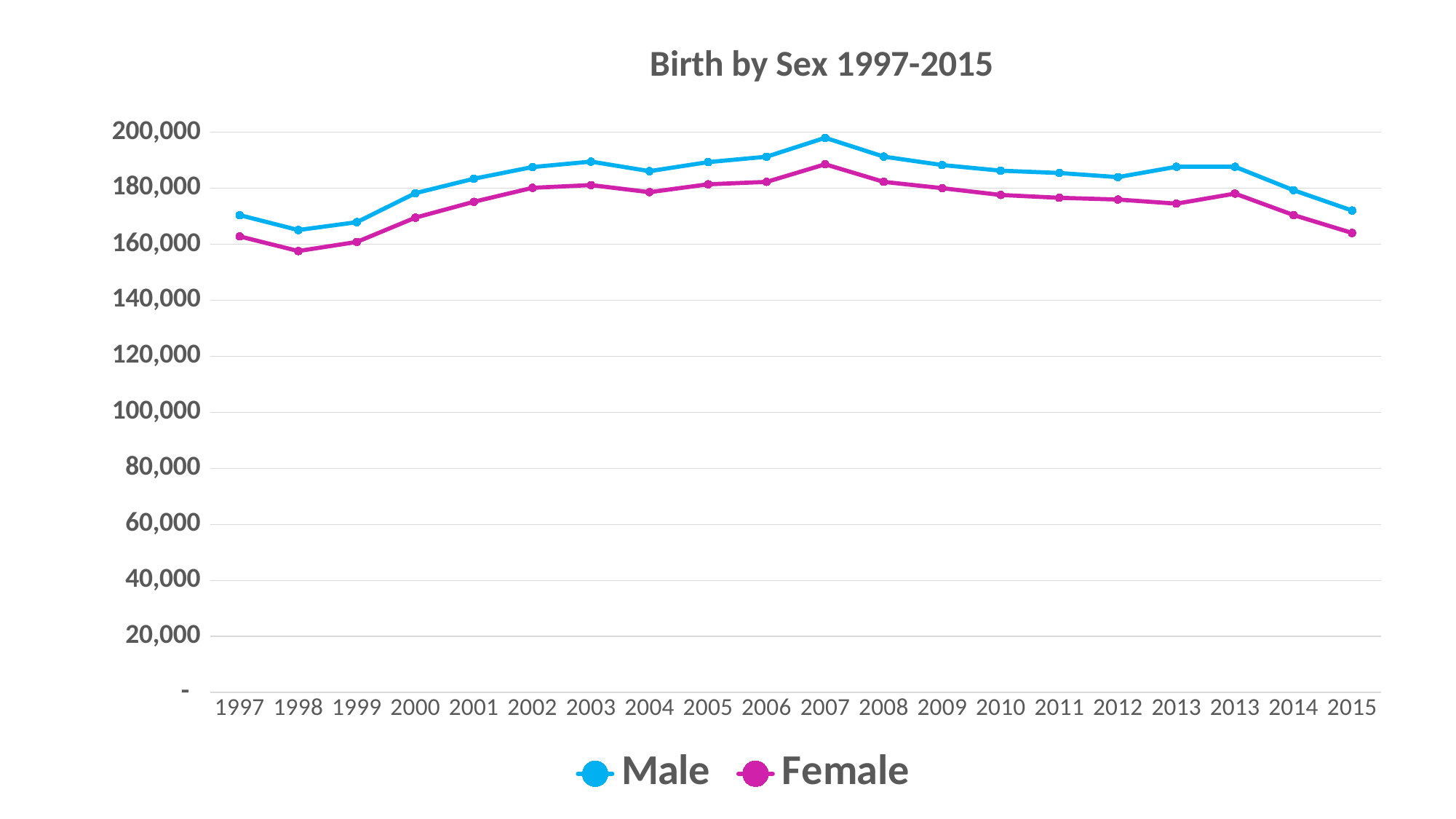
Is the Female value for 1998 greater or less than 180,000? less What kind of chart is shown on the slide? line chart In which year does the Male series reach its highest value? 2007 Does the Male series rise or fall overall from 2007 to 2015? fall In which year does the Female series reach its lowest value? 1998 In 2007, which series has the larger value, Male or Female? Male In which year does the Male series reach its lowest value? 1998 What is the title of the chart? Birth by Sex 1997-2015 Is the Male value for 2007 greater or less than 180,000? greater Which colour is used for the Male series? blue In which year does the Female series reach its highest value? 2007 How many series does the legend list? 2